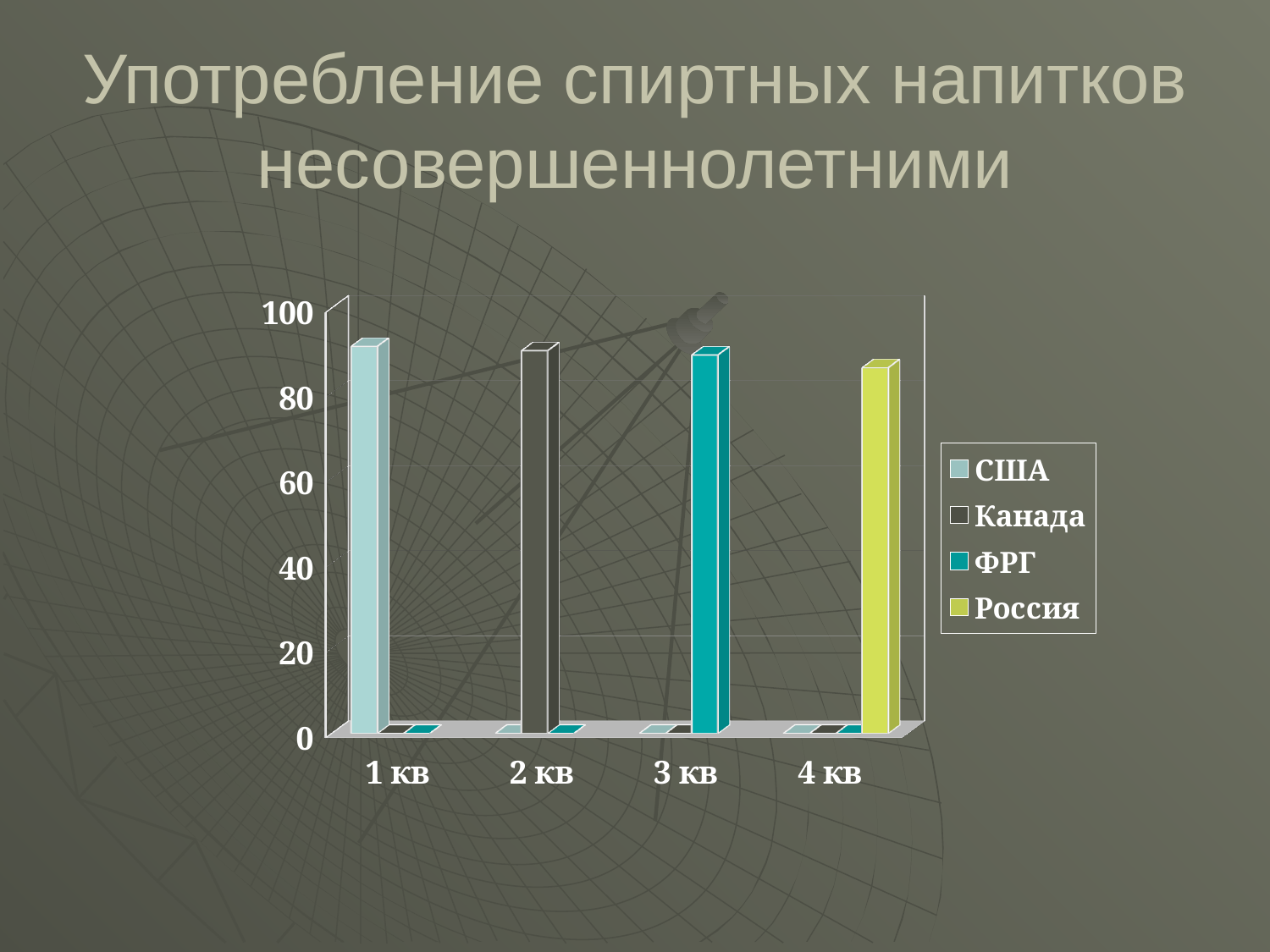
Is the value for Канада in 2 кв greater or less than 80? greater Is the value for ФРГ in 3 кв greater or less than 100? less Is the value for США in 1 кв greater or less than 80? greater What is the title of the slide? Употребление спиртных напитков несовершеннолетними Which is larger: the value for США in 1 кв or the value for Россия in 4 кв? США in 1 кв How many series does the legend list? 4 Which series is shown in the 4 кв category? Россия How many categories are shown on the x axis? 4 What kind of chart is shown on the slide? bar chart